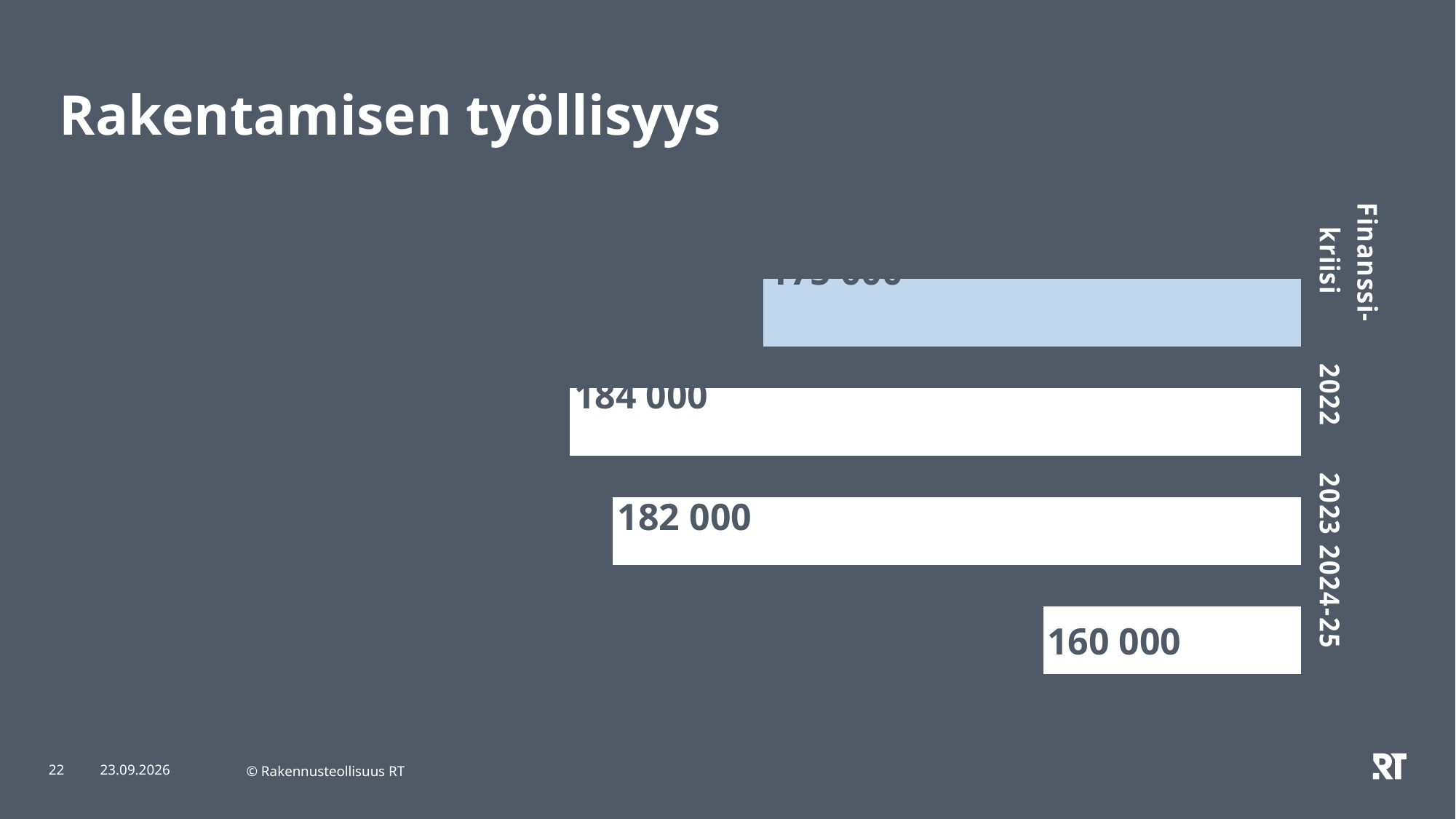
Which category has the highest value? 2022 How many categories are shown in the chart? 4 What is the value for 2023? 182 000 What is the title of the slide? Rakentamisen työllisyys Which is larger, the value for 2022 or the value for 2024-25? 2022 What is the difference between the values for 2023 and 2024-25? 22 000 What is the value for 2024-25? 160 000 What is the difference between the values for 2022 and 2023? 2 000 Do the values rise or fall from 2022 to 2024-25? Fall Which category has the lowest value? 2024-25 What kind of chart is shown on the slide? Bar chart What is the value for 2022? 184 000